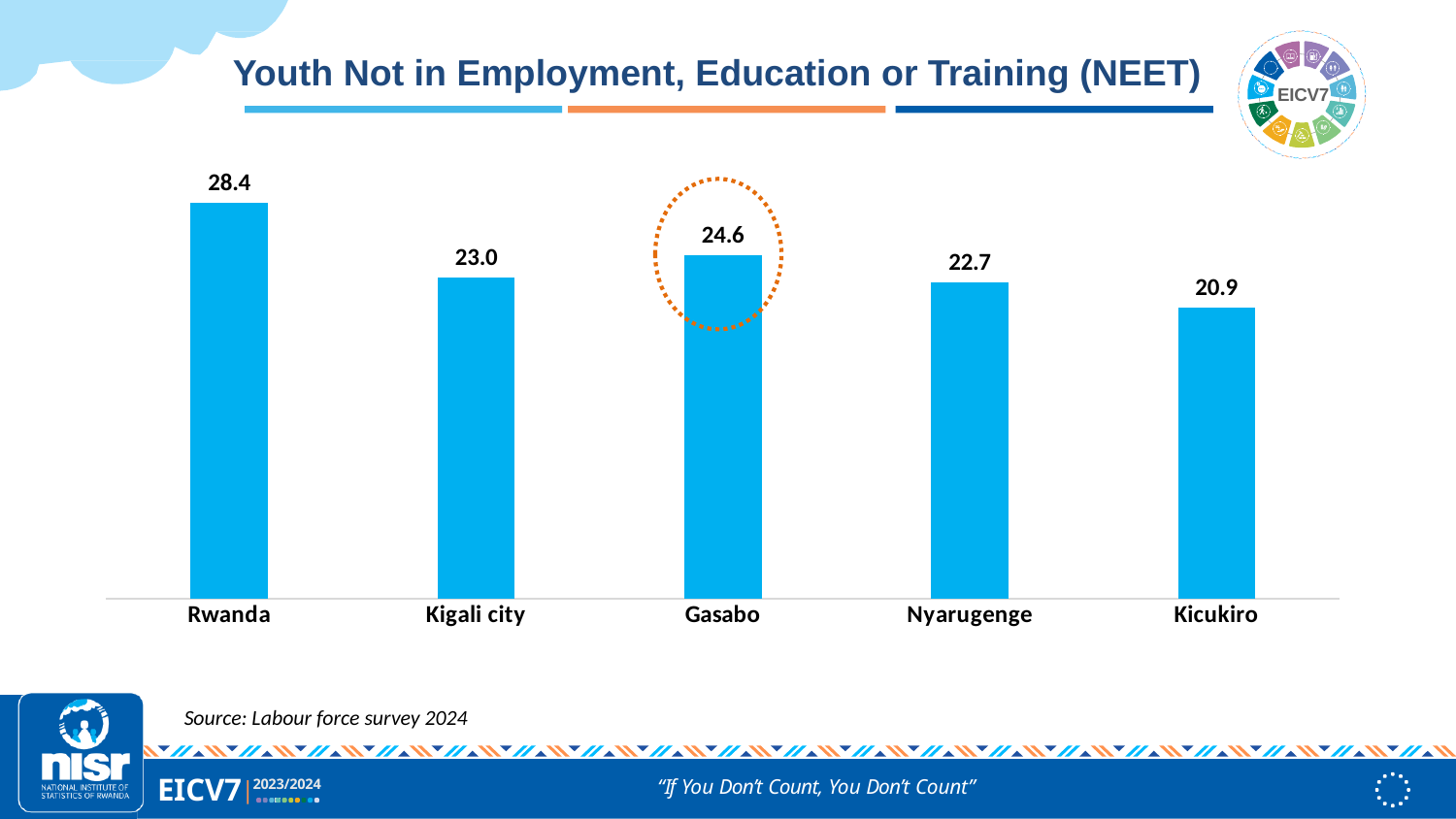
What is the difference between the NEET values for Gasabo and Kicukiro? 3.7 What is the NEET value for Rwanda? 28.4 What is the difference between the NEET values for Rwanda and Kigali city? 5.4 Which category has the lowest NEET value? Kicukiro Which has a higher NEET value, Gasabo or Nyarugenge? Gasabo What is the NEET value for Kicukiro? 20.9 What kind of chart is shown on the slide? Bar chart Which category has the highest NEET value? Rwanda What is the NEET value for Gasabo? 24.6 What is the title of the chart? Youth Not in Employment, Education or Training (NEET) How many categories are shown on the chart? 5 Which bar is highlighted with a dotted orange circle? Gasabo